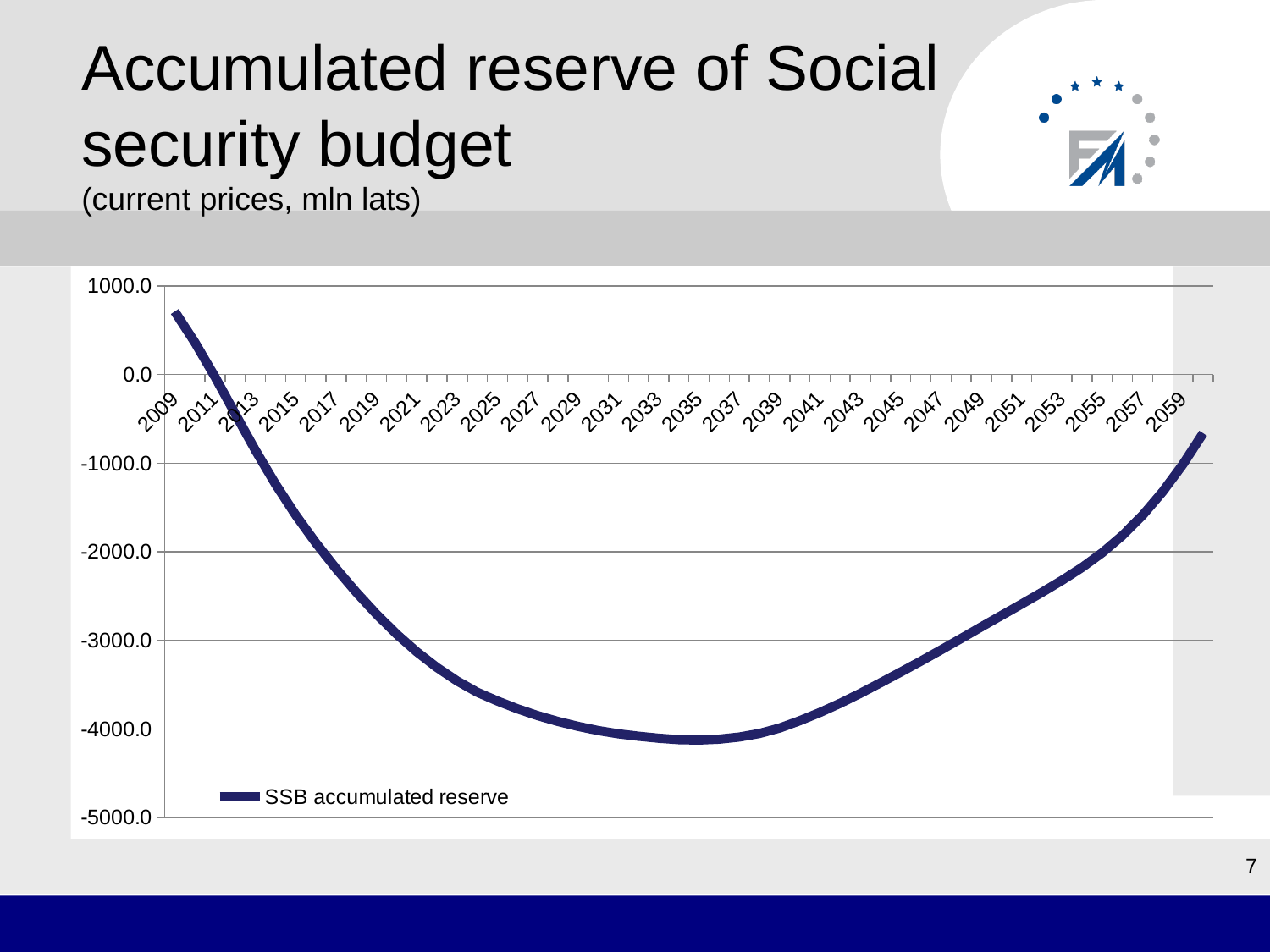
Does the SSB accumulated reserve rise or fall between 2009 and 2035? fall Is the value for 2053 greater or less than -2000.0? less How many series does the legend list? 1 Around which year does the SSB accumulated reserve reach its lowest value? 2035 What is the title of the chart on the slide? Accumulated reserve of Social security budget Is the value for 2025 greater or less than -3000.0? less What kind of chart is shown on the slide? line chart What is the name of the series shown in the legend? SSB accumulated reserve Which year has the larger value, 2009 or 2059? 2009 Is the value for 2009 greater or less than 0.0? greater